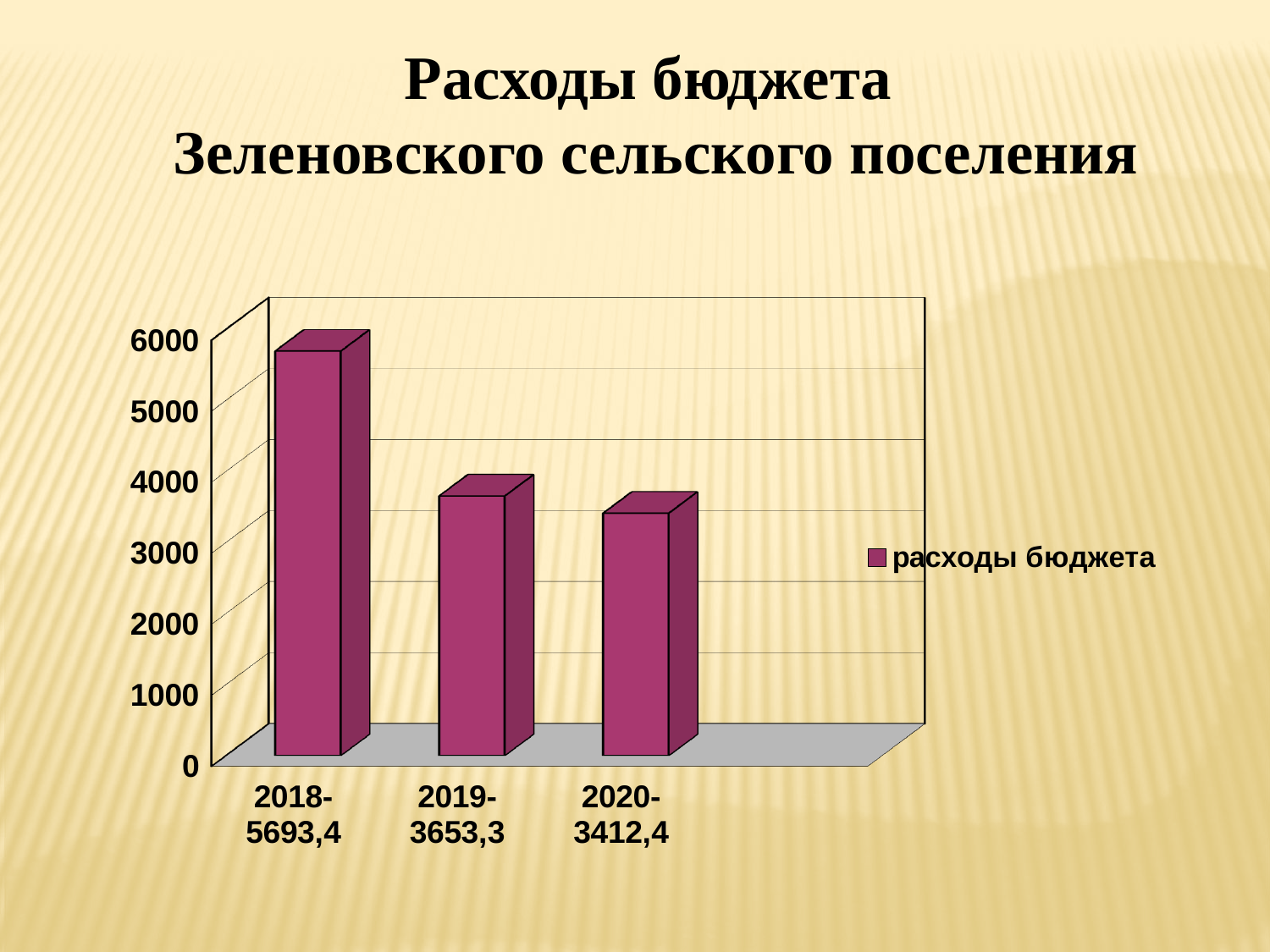
What is the value of budget expenditures (расходы бюджета) for 2019? 3653,3 How many years (categories) are shown in the chart? 3 What is the difference between the budget expenditures for 2019 and 2020? 240,9 What is the difference between the budget expenditures for 2018 and 2019? 2040,1 Is the value for 2018 greater or less than 5000? greater Which year has the highest budget expenditures? 2018 What type of chart is shown on the slide? bar chart Which is larger, the budget expenditures for 2019 or for 2020? 2019 What is the value of budget expenditures (расходы бюджета) for 2018? 5693,4 Do the budget expenditures rise or fall from 2018 to 2020? fall Which year has the lowest budget expenditures? 2020 What is the value of budget expenditures (расходы бюджета) for 2020? 3412,4